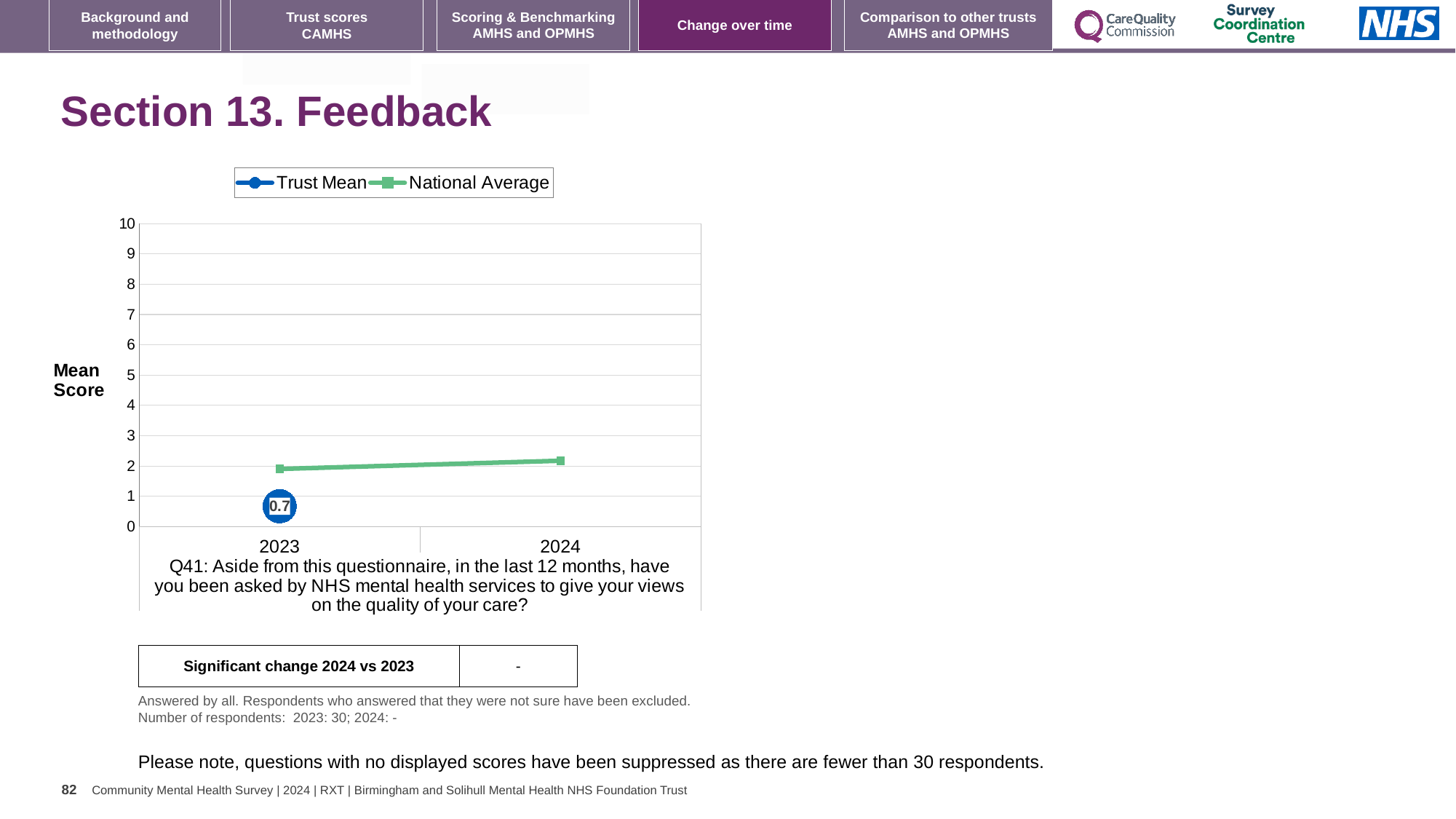
Does the National Average rise or fall from 2023 to 2024? rise How many series does the legend list? 2 What is the label on the vertical axis of the chart? Mean Score Is the Trust Mean value for 2023 greater or less than 1? less Is the National Average value for 2024 greater or less than 3? less How many years are shown on the x axis? 2 What is the Trust Mean value for 2023? 0.7 What kind of chart is shown on the slide? line chart What are the two series named in the legend? Trust Mean and National Average In 2023, which is larger: the Trust Mean or the National Average? National Average Is the National Average value for 2023 greater or less than 1? greater